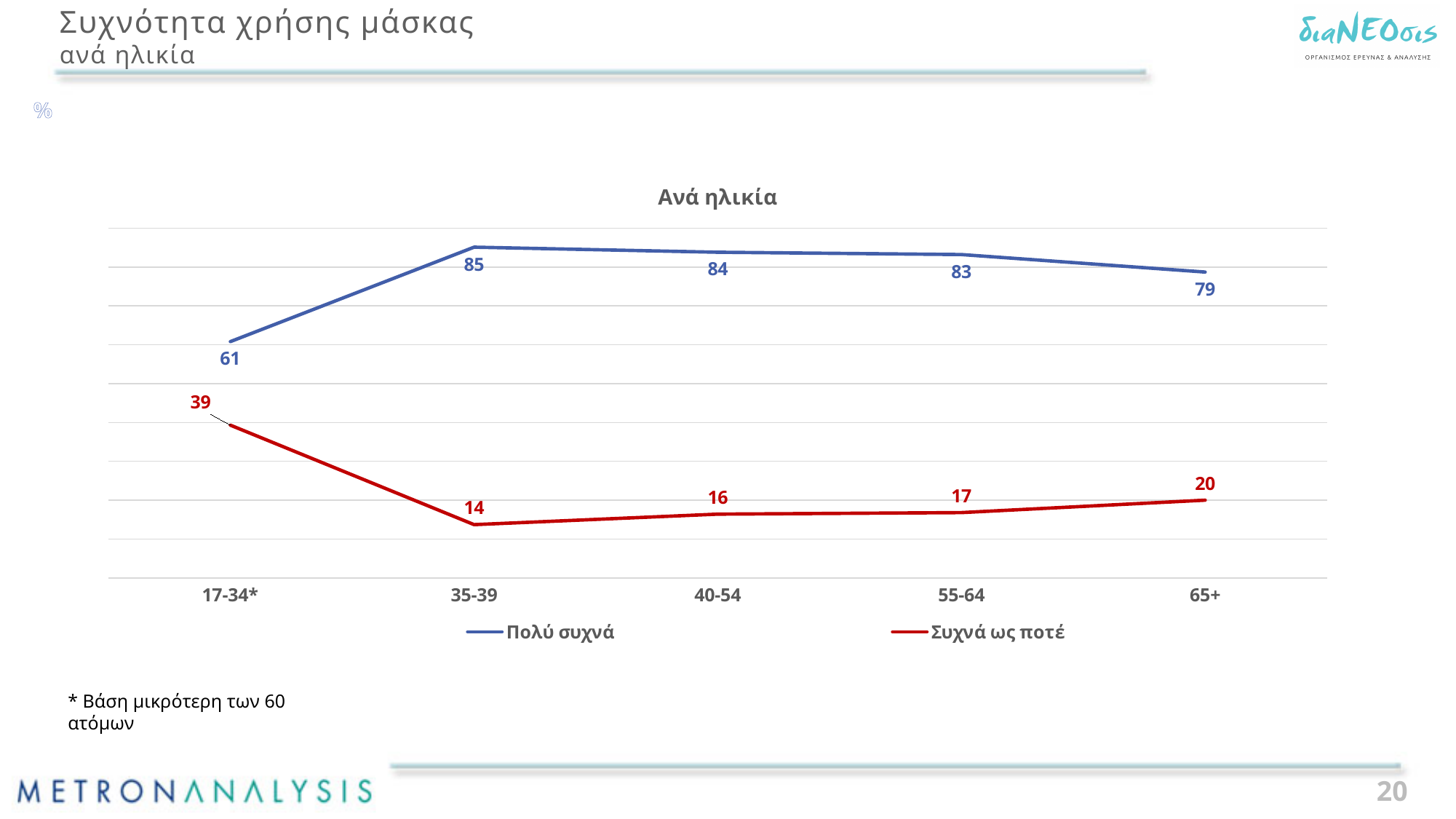
What is the value for "Πολύ συχνά" in the 35-39 age group? 85 Which is larger: the "Συχνά ως ποτέ" value for 55-64 or for 65+? 65+ What is the title of the chart? Ανά ηλικία What is the value for "Πολύ συχνά" in the 65+ age group? 79 Which age group has the highest value for "Πολύ συχνά"? 35-39 How many series does the legend list? 2 What kind of chart is shown on the slide? Line chart Does the "Συχνά ως ποτέ" line rise or fall from 35-39 to 65+? Rise Which age group has the lowest value for "Συχνά ως ποτέ"? 35-39 What is the value for "Συχνά ως ποτέ" in the 17-34* age group? 39 What is the difference between the "Πολύ συχνά" and "Συχνά ως ποτέ" values in the 17-34* age group? 22 How many age groups are shown on the x axis? 5